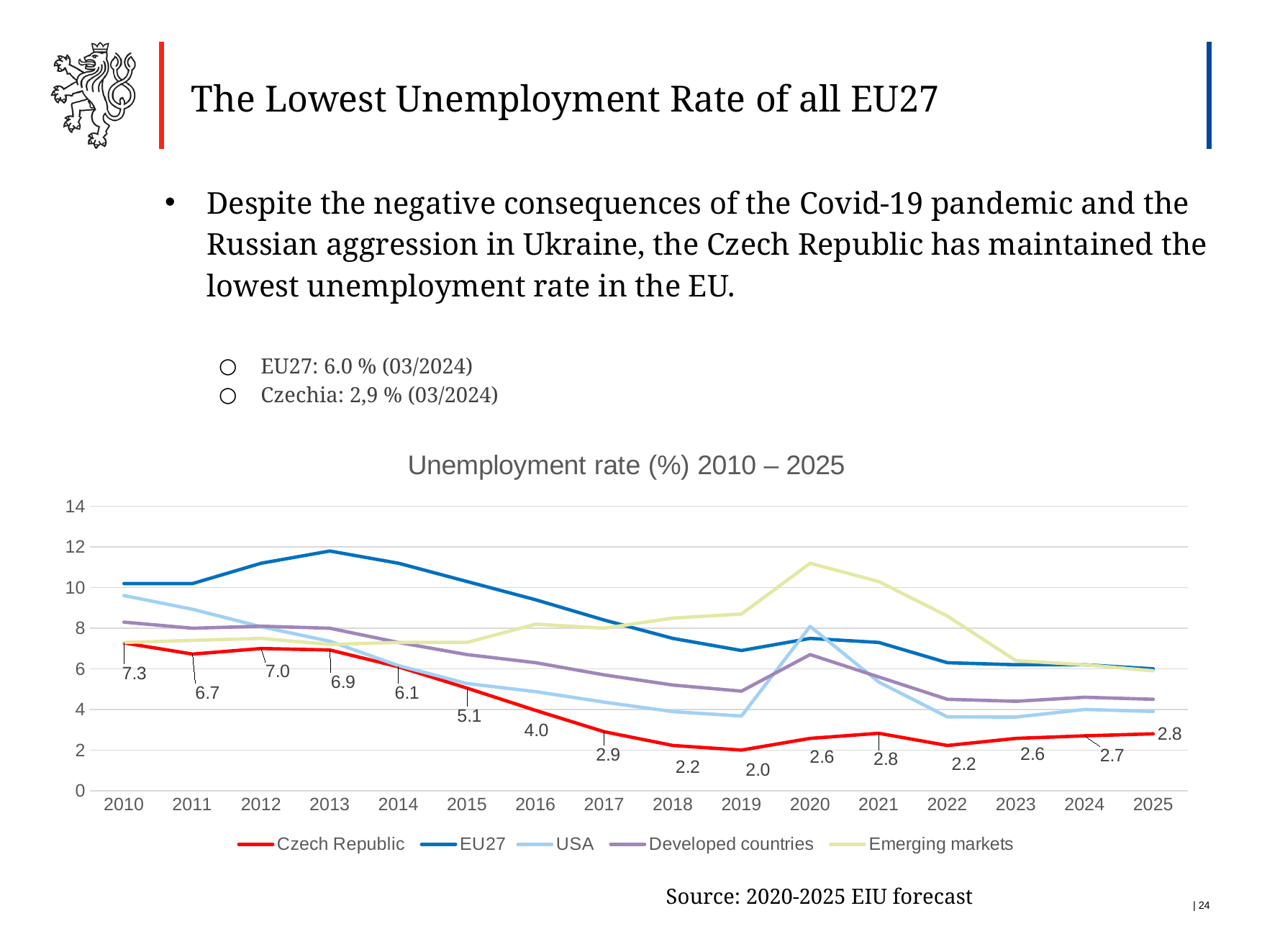
In which year is the Czech Republic's unemployment rate highest? 2010 What is the title of the chart? Unemployment rate (%) 2010 – 2025 What is the unemployment rate for the Czech Republic in 2019? 2.0 Is the EU27 unemployment rate in 2013 greater or less than 10? greater What is the unemployment rate for the Czech Republic in 2025? 2.8 Which series has the higher unemployment rate in 2020, Emerging markets or EU27? Emerging markets What is the unemployment rate for the Czech Republic in 2010? 7.3 How many series does the chart legend list? 5 What is the difference between the Czech Republic's unemployment rate in 2010 and in 2019? 5.3 What type of chart is shown on the slide? line chart How many years are shown on the x axis of the chart? 16 In which year is the Czech Republic's unemployment rate lowest? 2019